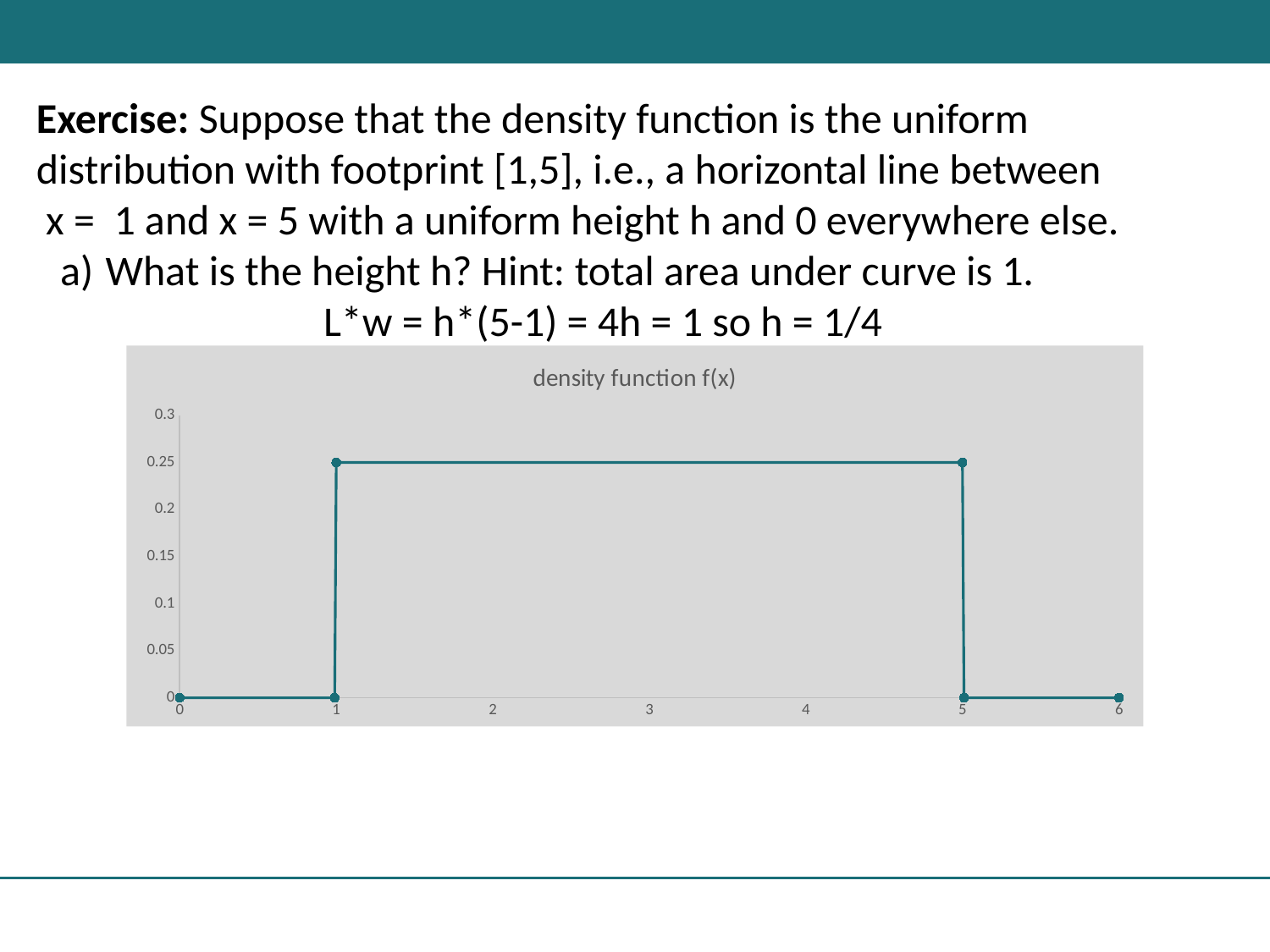
What is the value of the density function f(x) at x = 6? 0 Is the value of f(x) at x = 2 greater or less than 0.2? greater What kind of chart is shown on the slide? line chart What is the value of the density function f(x) at x = 3? 0.25 What is the value of the density function f(x) at x = 0? 0 What is the title of the chart? density function f(x) What is the difference between the value of f(x) at x = 3 and at x = 6? 0.25 What is the highest value reached by the plotted line? 0.25 Does the plotted line rise, fall, or stay flat between x = 1 and x = 5? stays flat What is the lowest value reached by the plotted line? 0 Is the value of f(x) at x = 4 greater or less than 0.3? less Which is larger, the value of f(x) at x = 3 or at x = 6? x = 3